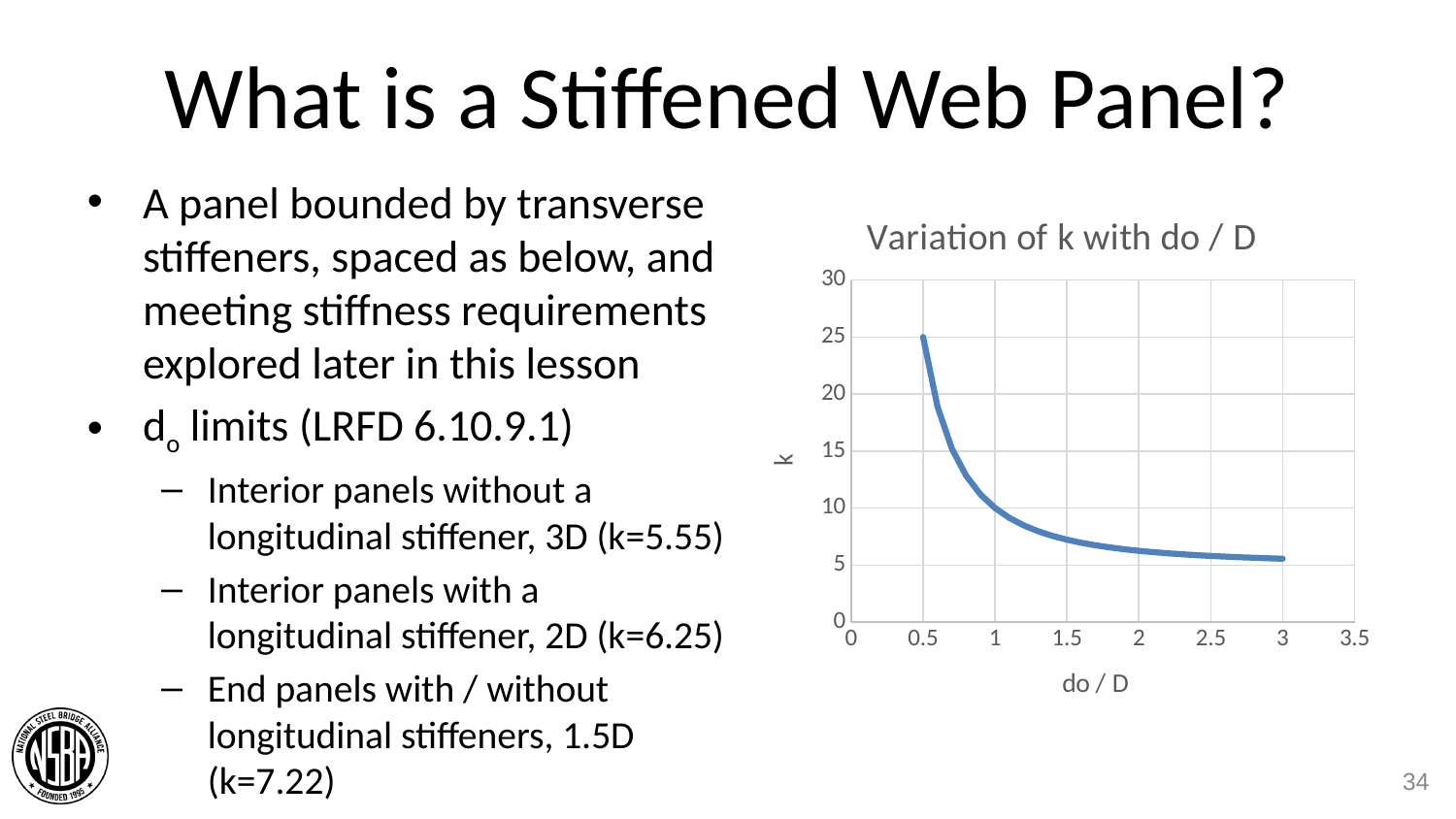
What kind of chart is shown on the slide? line chart What is the label of the horizontal axis of the chart? do / D Which has the larger value of k: do / D = 0.5 or do / D = 3? do / D = 0.5 How many data series are plotted on the chart? 1 What is the title of the chart? Variation of k with do / D Is the value of k at do / D = 3 greater or less than 10? less Is the value of k at do / D = 0.5 greater or less than 20? greater Is the value of k at do / D = 1 greater or less than 15? less What is the highest value shown on the vertical (k) axis? 30 Does k rise or fall as do / D increases along the x axis? fall What is the value of k at do / D = 0.5, where the curve begins? 25